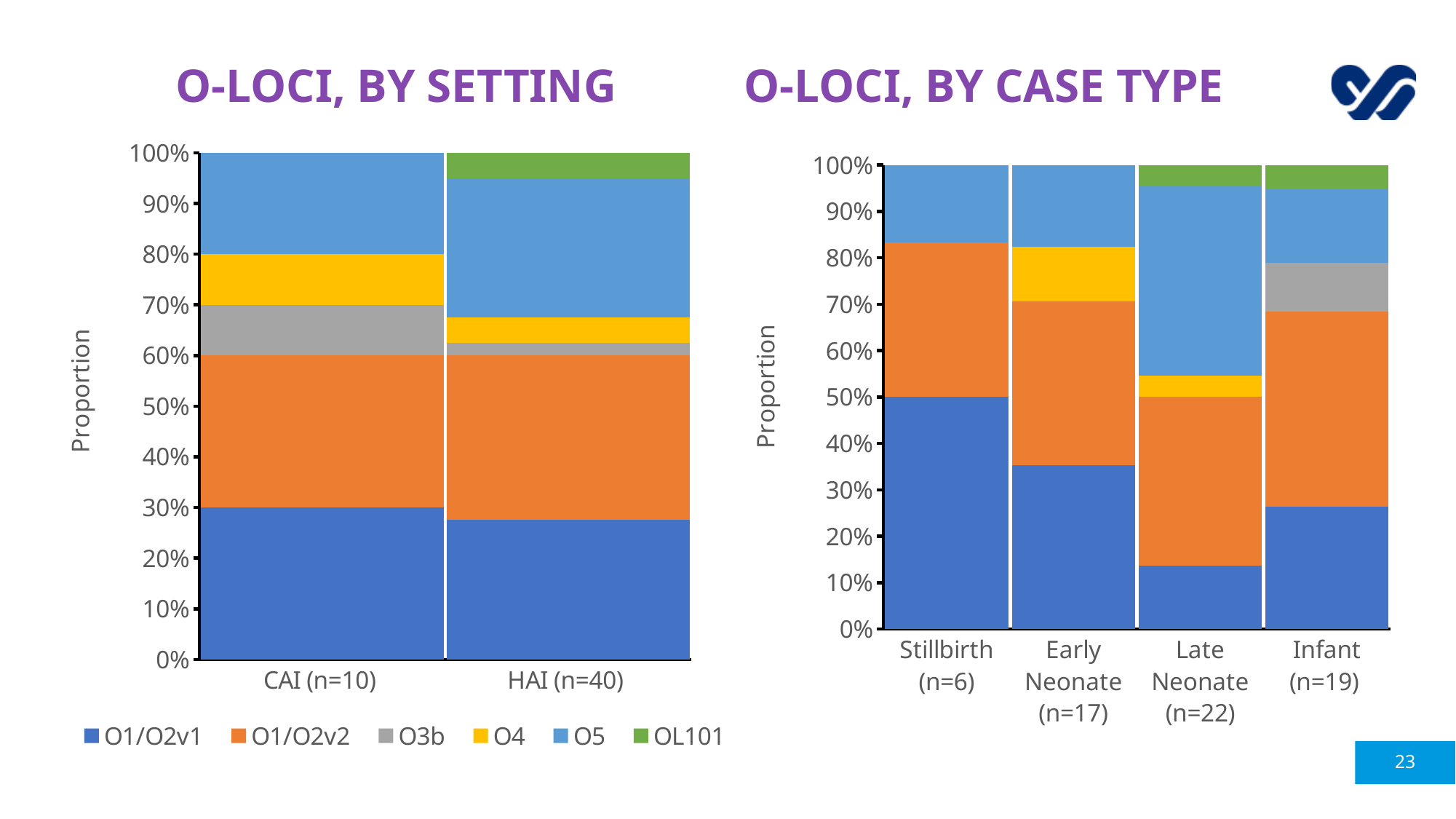
In the 'O-LOCI, BY CASE TYPE' chart, is the O1/O2v1 proportion for Stillbirth (n=6) greater or less than 40%? greater In the 'O-LOCI, BY CASE TYPE' chart, which category has the largest O5 proportion? Late Neonate (n=22) In the 'O-LOCI, BY SETTING' chart, is the O5 proportion for HAI (n=40) greater or less than 20%? greater How many series does the legend list? 6 In the 'O-LOCI, BY SETTING' chart, which setting has the larger O4 proportion, CAI (n=10) or HAI (n=40)? CAI (n=10) How many categories are shown on the x axis of the 'O-LOCI, BY CASE TYPE' chart? 4 What is the label on the y axis of the 'O-LOCI, BY CASE TYPE' chart? Proportion How many categories are shown on the x axis of the 'O-LOCI, BY SETTING' chart? 2 Which legend entry is shown in yellow? O4 In the 'O-LOCI, BY CASE TYPE' chart, which category has the larger O1/O2v1 proportion, Stillbirth (n=6) or Late Neonate (n=22)? Stillbirth (n=6) What kind of chart is the 'O-LOCI, BY SETTING' chart on the left? Stacked bar chart In the 'O-LOCI, BY CASE TYPE' chart, is the O1/O2v1 proportion for Late Neonate (n=22) greater or less than 20%? less